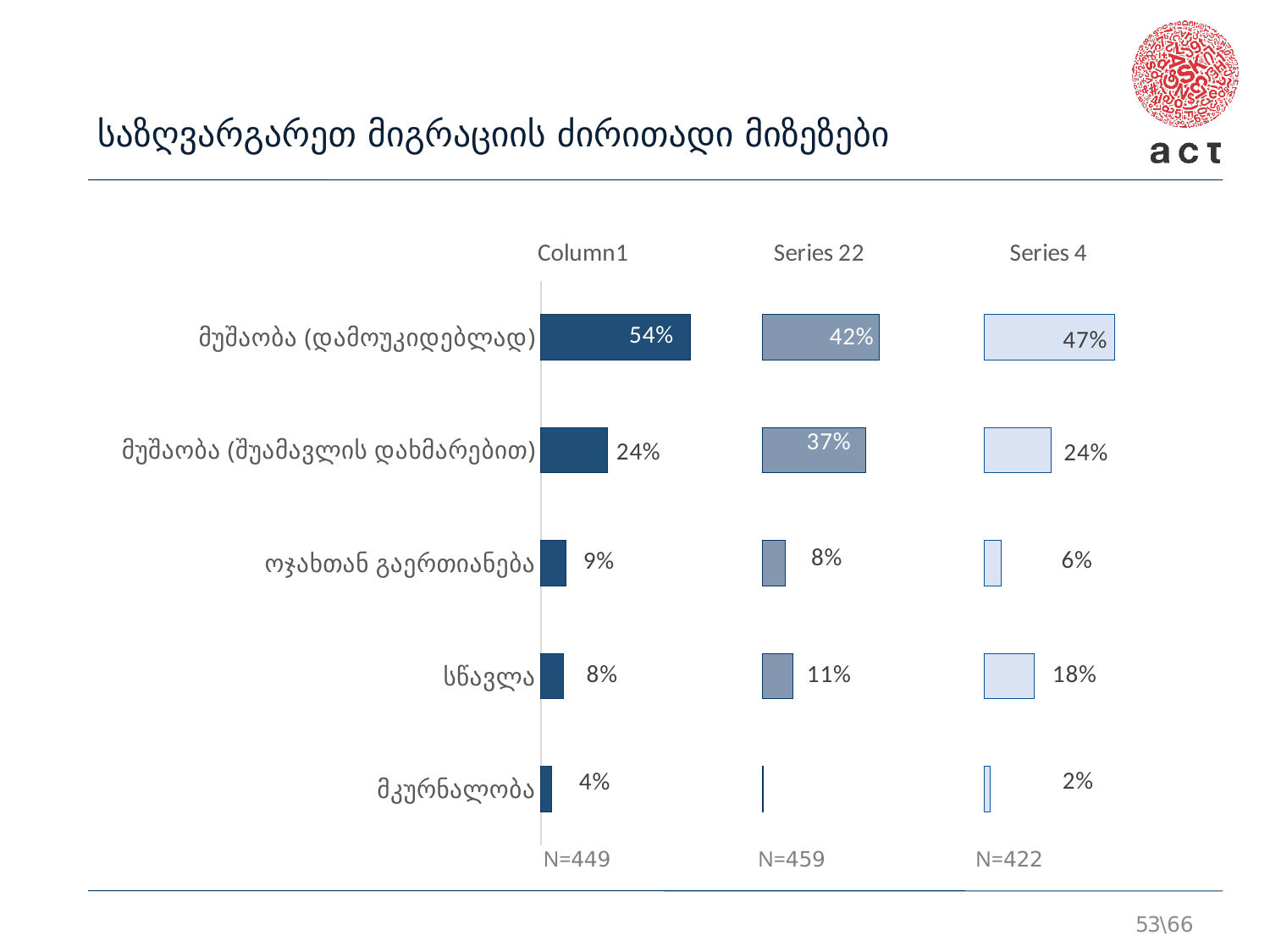
Which category has the lowest value in Column1? მკურნალობა How many categories are shown in the chart? 5 What is the Column1 value for მკურნალობა? 4% What is the sample size (N) shown under the Series 22 column? N=459 How many series does the chart show? 3 What is the Column1 value for მუშაობა (დამოუკიდებლად)? 54% Which is larger for სწავლა: the Series 22 value or the Series 4 value? Series 4 Which category has the highest value in Series 4? მუშაობა (დამოუკიდებლად) What is the Series 4 value for სწავლა? 18% What is the difference between the Column1 and Series 22 values for მუშაობა (დამოუკიდებლად)? 12% What is the Series 22 value for მუშაობა (შუამავლის დახმარებით)? 37% What kind of chart is shown on the slide? bar chart